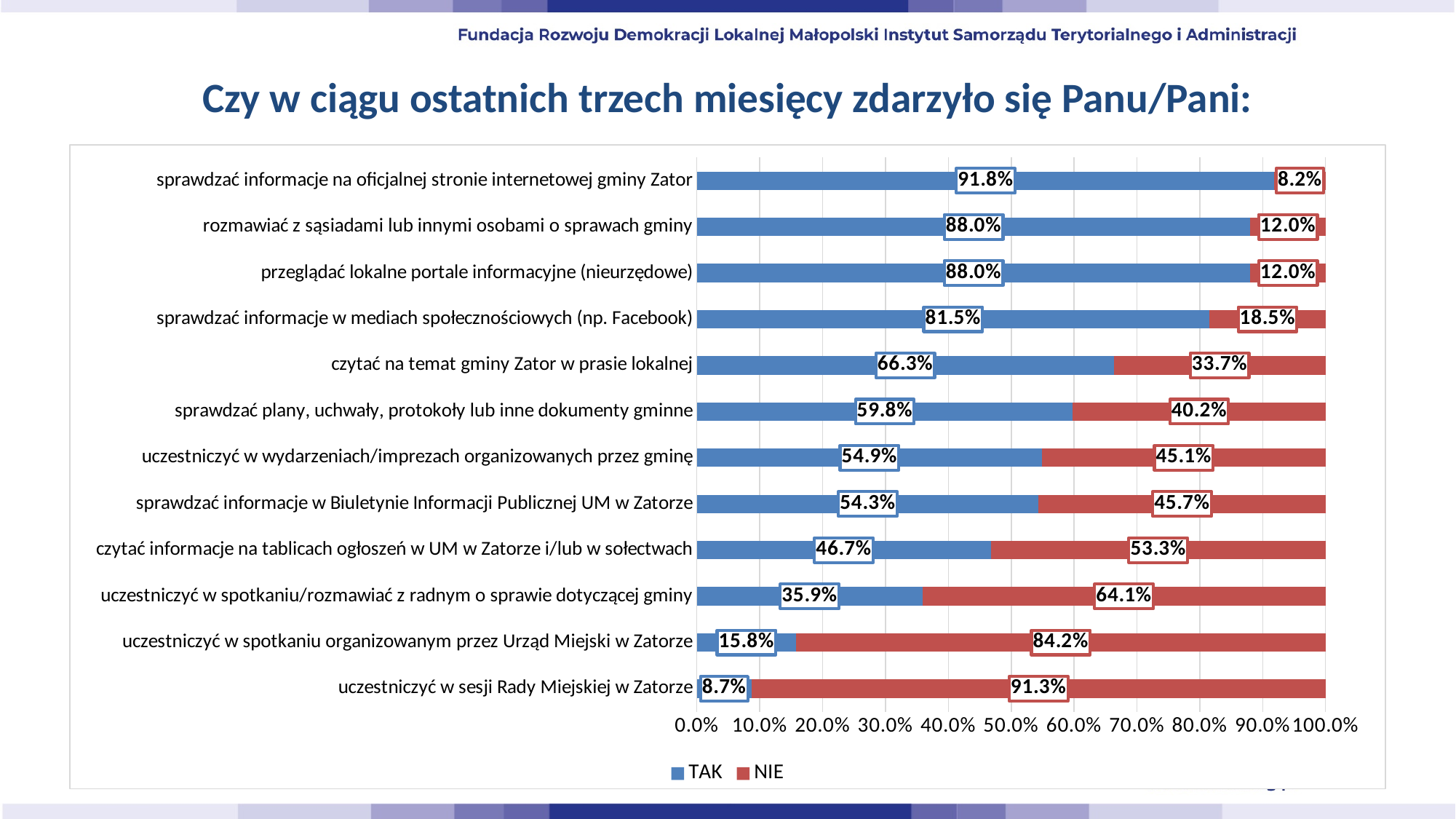
Which category has the lowest TAK value? uczestniczyć w sesji Rady Miejskiej w Zatorze How many categories are shown in the chart? 12 How many series does the legend list? 2 Which colour represents the NIE series in the chart? Red Which category has the highest TAK value? sprawdzać informacje na oficjalnej stronie internetowej gminy Zator What kind of chart is shown on the slide? Stacked bar chart Which is larger: the TAK value for "sprawdzać plany, uchwały, protokoły lub inne dokumenty gminne" or the TAK value for "uczestniczyć w wydarzeniach/imprezach organizowanych przez gminę"? sprawdzać plany, uchwały, protokoły lub inne dokumenty gminne What is the total of the stacked bar for "sprawdzać informacje w mediach społecznościowych (np. Facebook)"? 100.0% What is the NIE value for "uczestniczyć w sesji Rady Miejskiej w Zatorze"? 91.3% What is the TAK value for "czytać na temat gminy Zator w prasie lokalnej"? 66.3% What is the difference between the NIE value for "uczestniczyć w spotkaniu organizowanym przez Urząd Miejski w Zatorze" and the NIE value for "uczestniczyć w spotkaniu/rozmawiać z radnym o sprawie dotyczącej gminy"? 20.1% What is the TAK value for "sprawdzać informacje na oficjalnej stronie internetowej gminy Zator"? 91.8%